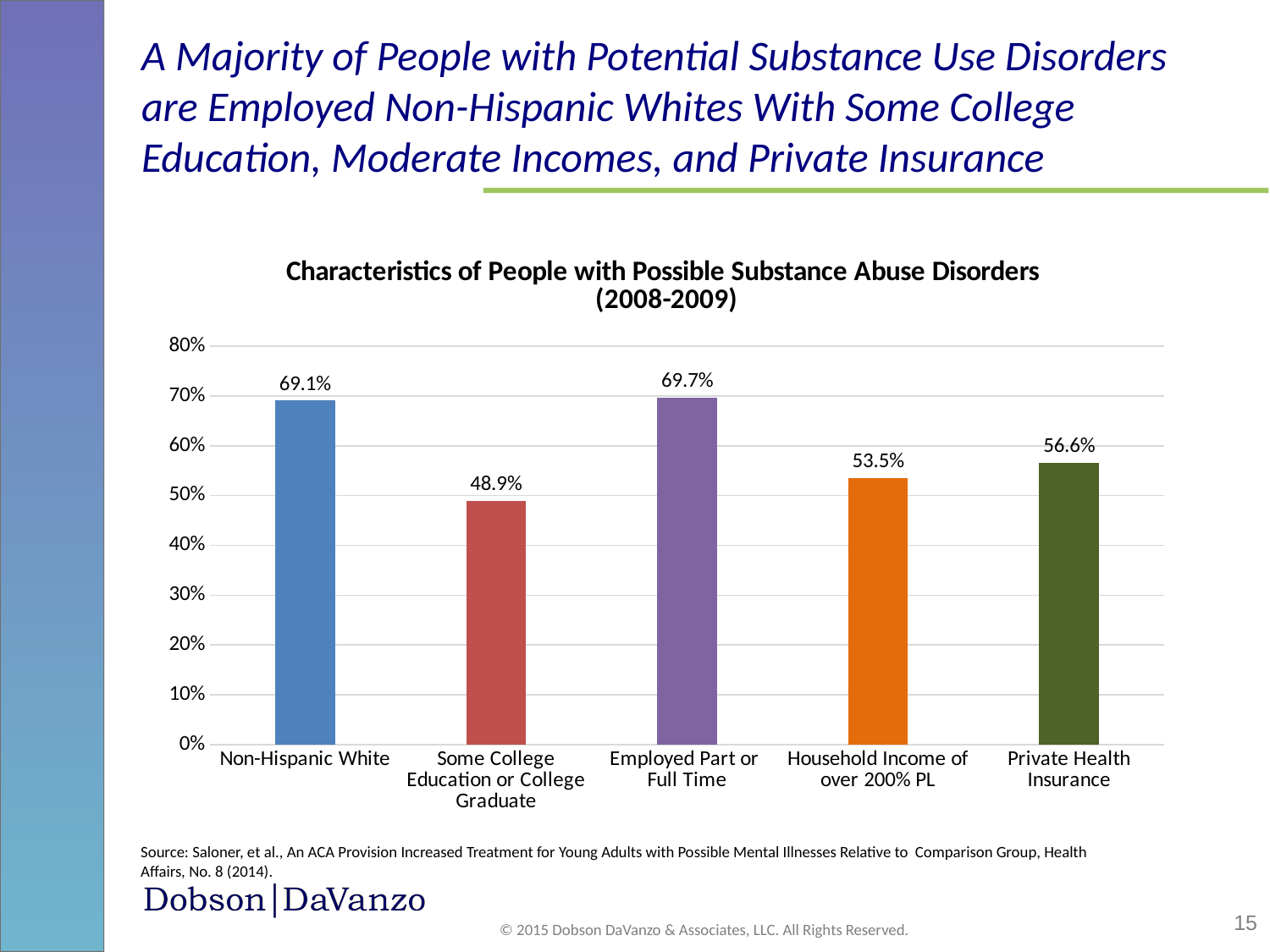
What kind of chart is shown on the slide? bar chart Which is larger, the value for Private Health Insurance or the value for Household Income of over 200% PL? Private Health Insurance What is the value for Non-Hispanic White? 69.1% What is the title of the chart? Characteristics of People with Possible Substance Abuse Disorders (2008-2009) Which category has the highest value? Employed Part or Full Time Which category has the lowest value? Some College Education or College Graduate How many categories are shown in the chart? 5 What is the difference between the values for Employed Part or Full Time and Some College Education or College Graduate? 20.8% What is the value for Some College Education or College Graduate? 48.9% Is the value for Some College Education or College Graduate greater or less than 50%? less What is the value for Household Income of over 200% PL? 53.5% What is the value for Private Health Insurance? 56.6%